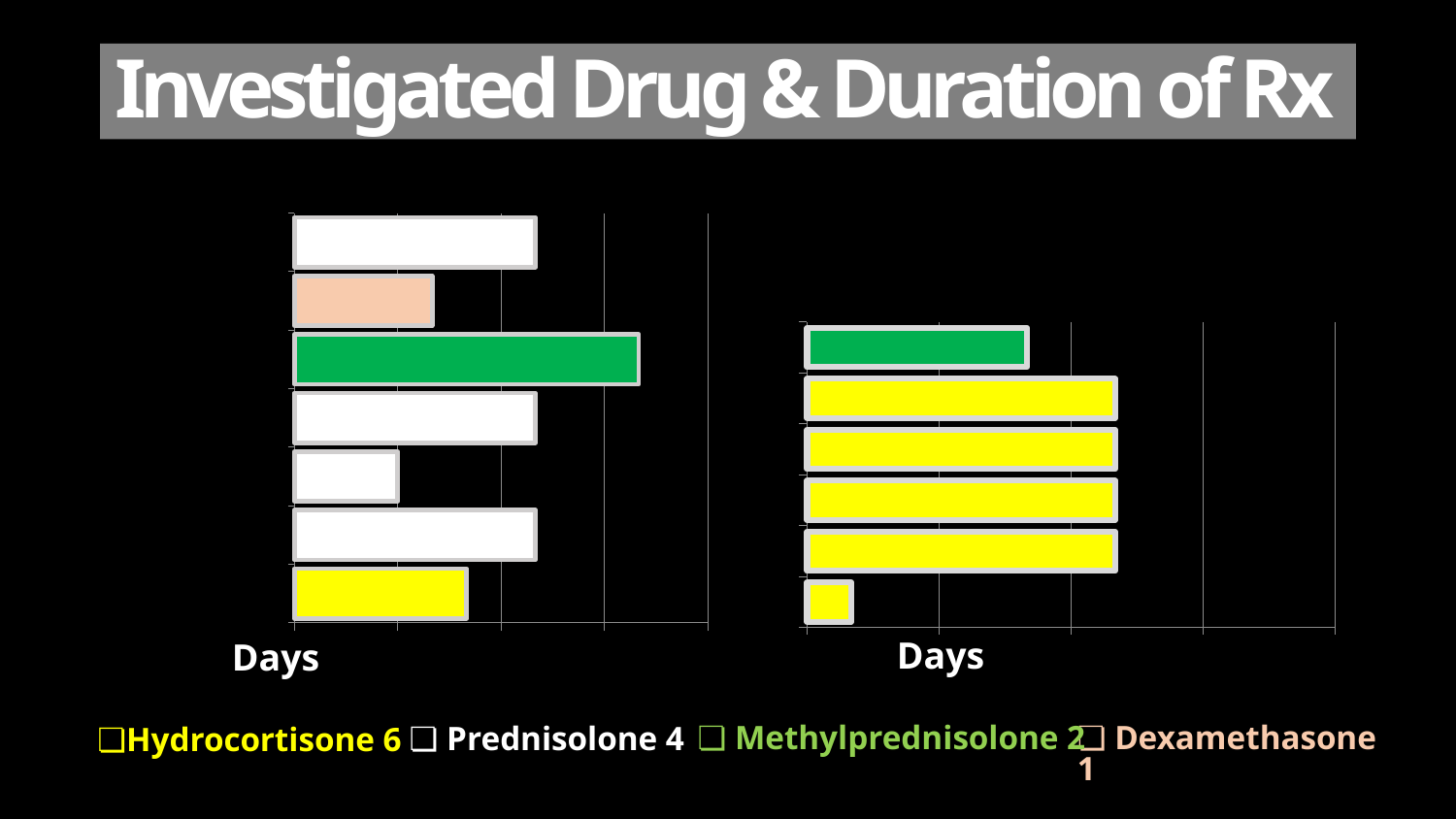
How many yellow (Hydrocortisone) bars are in the right chart? 5 What is the x-axis label of both charts? Days How many bars are plotted in the left chart? 7 Which colour represents Hydrocortisone in the legend? yellow How many white (Prednisolone) bars are in the left chart? 4 In the right chart, is the Methylprednisolone bar longer or shorter than the Hydrocortisone bars above the bottom one? shorter In the left chart, which drug has the longest bar? Methylprednisolone How many series does the legend list? 4 In the left chart, is the Dexamethasone bar longer or shorter than the Methylprednisolone bar? shorter What kind of chart is shown on the left of the slide? bar chart In the right chart, which drug has the shortest bar? Hydrocortisone